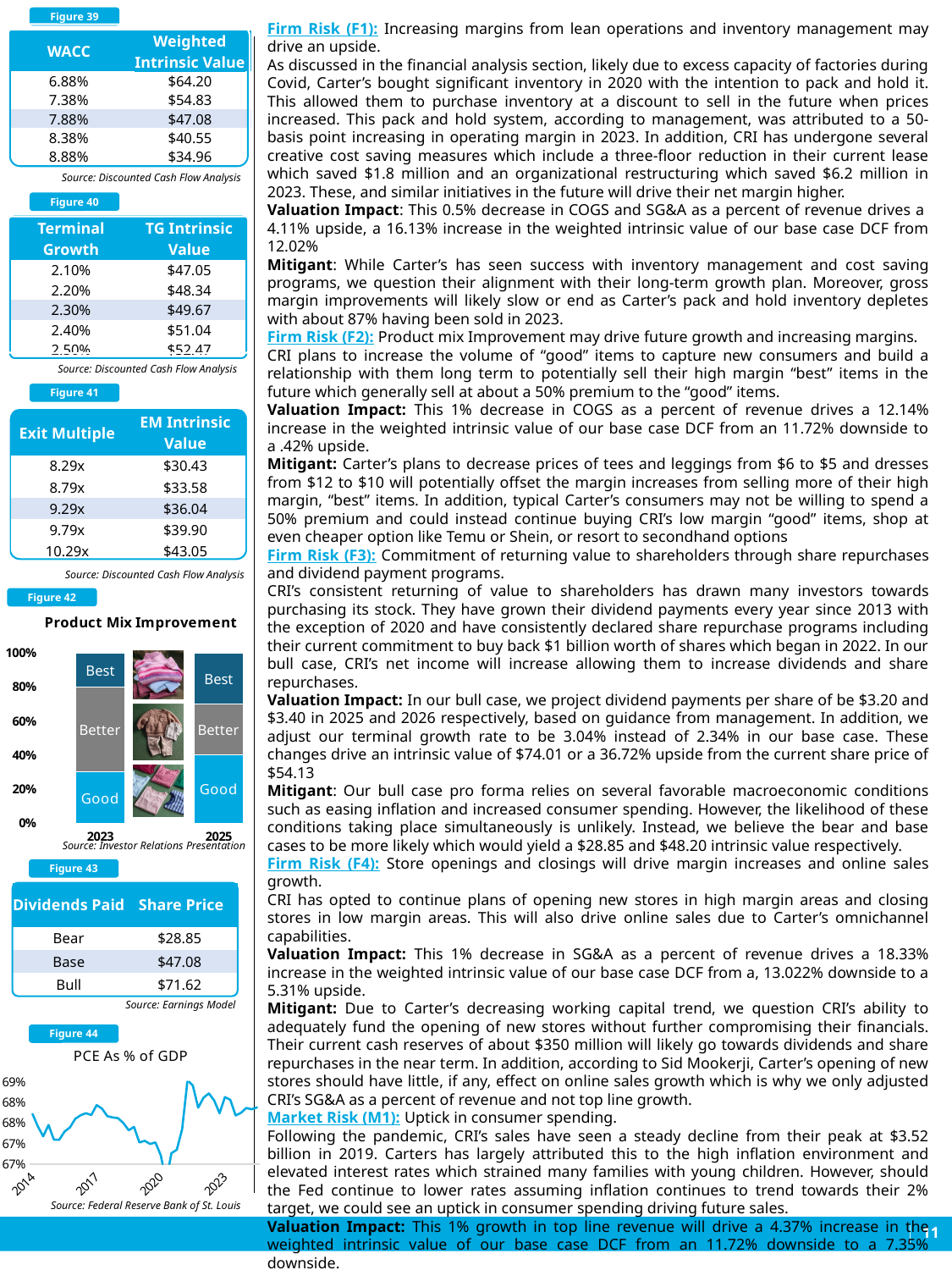
What type of chart is Figure 44, "PCE As % of GDP"? Line chart In the "PCE As % of GDP" chart, near which x-axis year does the line reach its lowest point? 2020 In the "Product Mix Improvement" chart, is the "Better" segment larger in 2023 or in 2025? 2023 What type of chart is Figure 42, "Product Mix Improvement"? Stacked bar chart What is the title of the chart in Figure 44? PCE As % of GDP In the "Product Mix Improvement" chart, what is the total height of the 2023 stacked bar? 100% In the "Product Mix Improvement" chart, how many years are shown on the x axis? 2 In the "Product Mix Improvement" chart, how many product tiers make up each stacked bar? 3 In the "PCE As % of GDP" chart, how many year labels are shown on the x axis? 4 In the "PCE As % of GDP" chart, is the value at 2014 greater or less than 69%? less In the "Product Mix Improvement" chart, is the "Good" share in 2023 greater or less than 60%? less In the "Product Mix Improvement" chart, what are the three segments of each bar labelled? Best, Better, Good